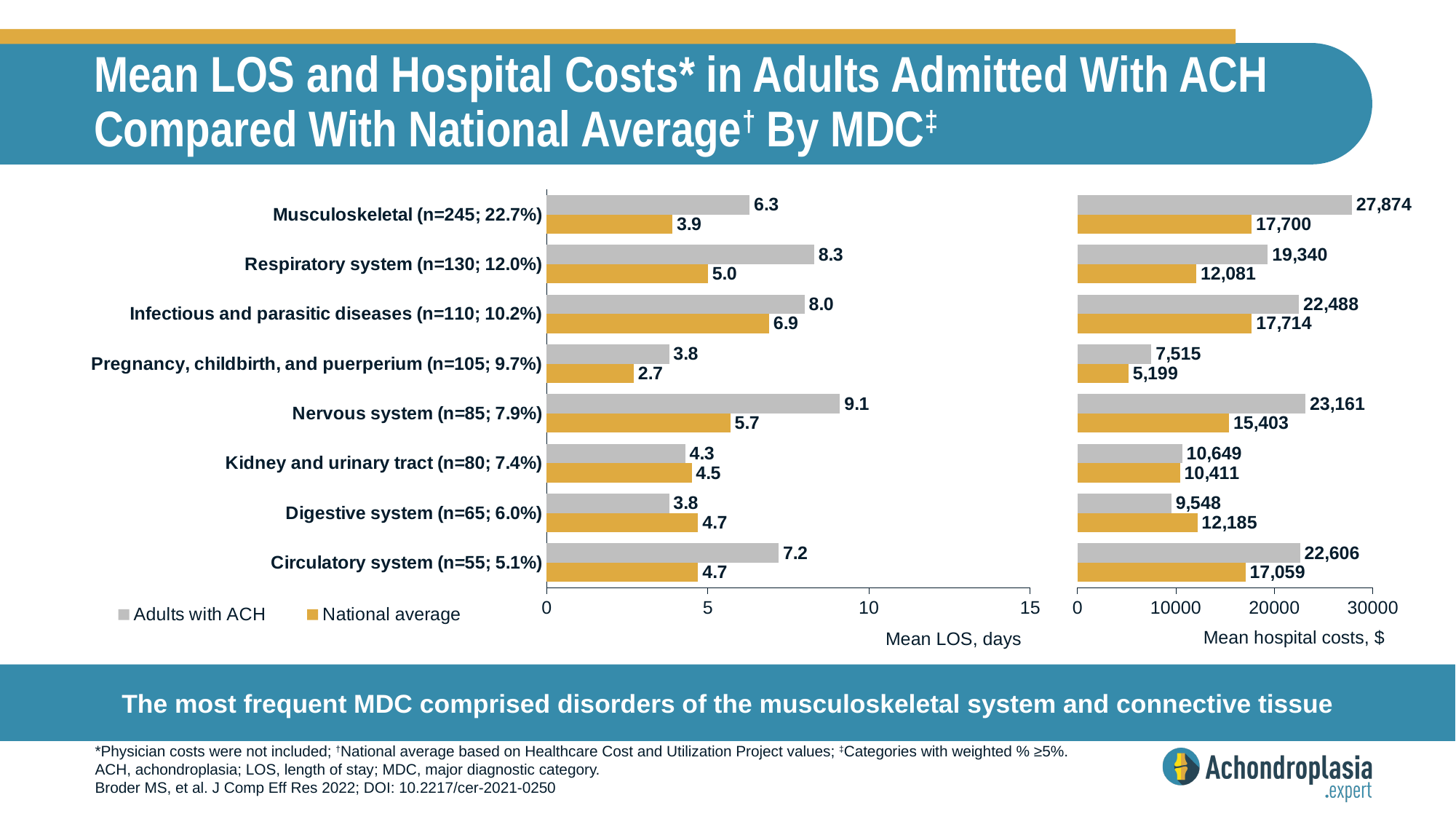
In the Mean hospital costs, $ chart, what is the mean hospital cost for the National average in the Respiratory system category? 12,081 In the Mean hospital costs, $ chart, is the Adults with ACH value for Circulatory system greater or less than 20000? greater In the Mean LOS, days chart, which category has the highest mean LOS for Adults with ACH? Nervous system In the Mean LOS, days chart, what is the difference between the Adults with ACH and National average values for the Respiratory system category? 3.3 How many series does the legend list for the charts? 2 How many MDC categories are shown in the Mean LOS, days chart? 8 In the Mean hospital costs, $ chart, what is the difference between the Adults with ACH and National average costs for the Musculoskeletal category? 10,174 Which colour represents the National average series in the charts? Gold In the Mean LOS, days chart, what is the mean LOS for Adults with ACH in the Nervous system category? 9.1 What type of chart is the Mean hospital costs, $ chart? Bar chart In the Mean LOS, days chart, which is larger for the Digestive system category: Adults with ACH or National average? National average In the Mean hospital costs, $ chart, which category has the lowest mean hospital cost for the National average? Pregnancy, childbirth, and puerperium